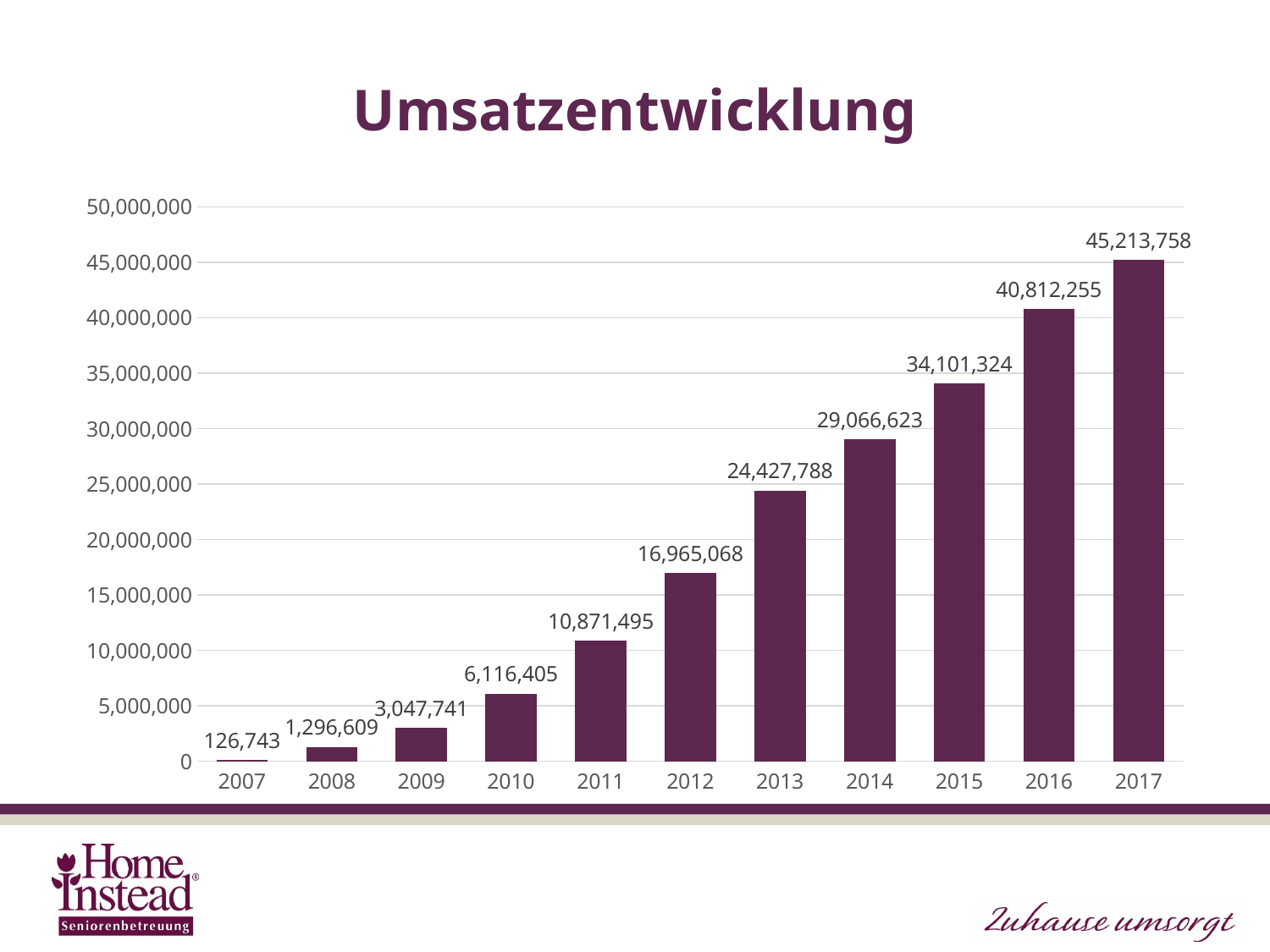
Which year has the highest value? 2017 Which year has the lowest value? 2007 What is the value for 2008? 1,296,609 What is the difference between the values for 2012 and 2011? 6,093,573 What is the value for 2013? 24,427,788 Which is larger, the value for 2014 or the value for 2015? 2015 Do the values rise or fall from 2007 to 2017? rise What is the difference between the values for 2017 and 2016? 4,401,503 What is the value for 2016? 40,812,255 Is the value for 2015 greater or less than 30,000,000? greater How many years are shown on the x axis? 11 What kind of chart is shown on the slide? bar chart